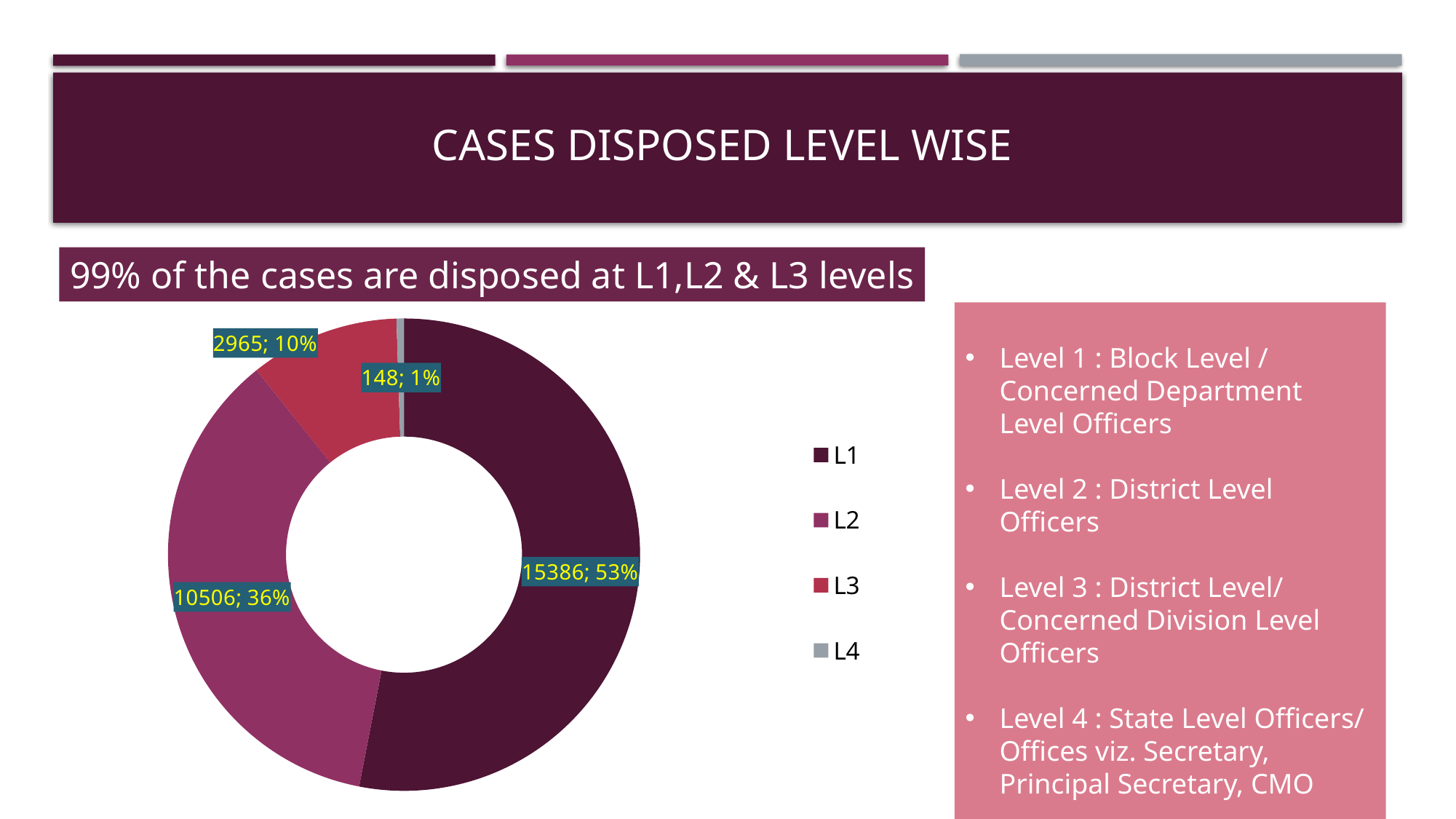
Which level has the highest number of cases disposed? L1 What share of the cases were disposed at level L2? 36% Which level has the lowest number of cases disposed? L4 What is the title of the slide containing the chart? CASES DISPOSED LEVEL WISE How many cases were disposed at level L1? 15386 How many cases were disposed at level L2? 10506 What share of the cases were disposed at level L1? 53% How many cases were disposed at level L3? 2965 How many cases were disposed at level L4? 148 What is the difference between the number of cases disposed at L1 and at L2? 4880 How many levels (categories) does the chart show? 4 What kind of chart is shown on the slide? Doughnut (pie) chart